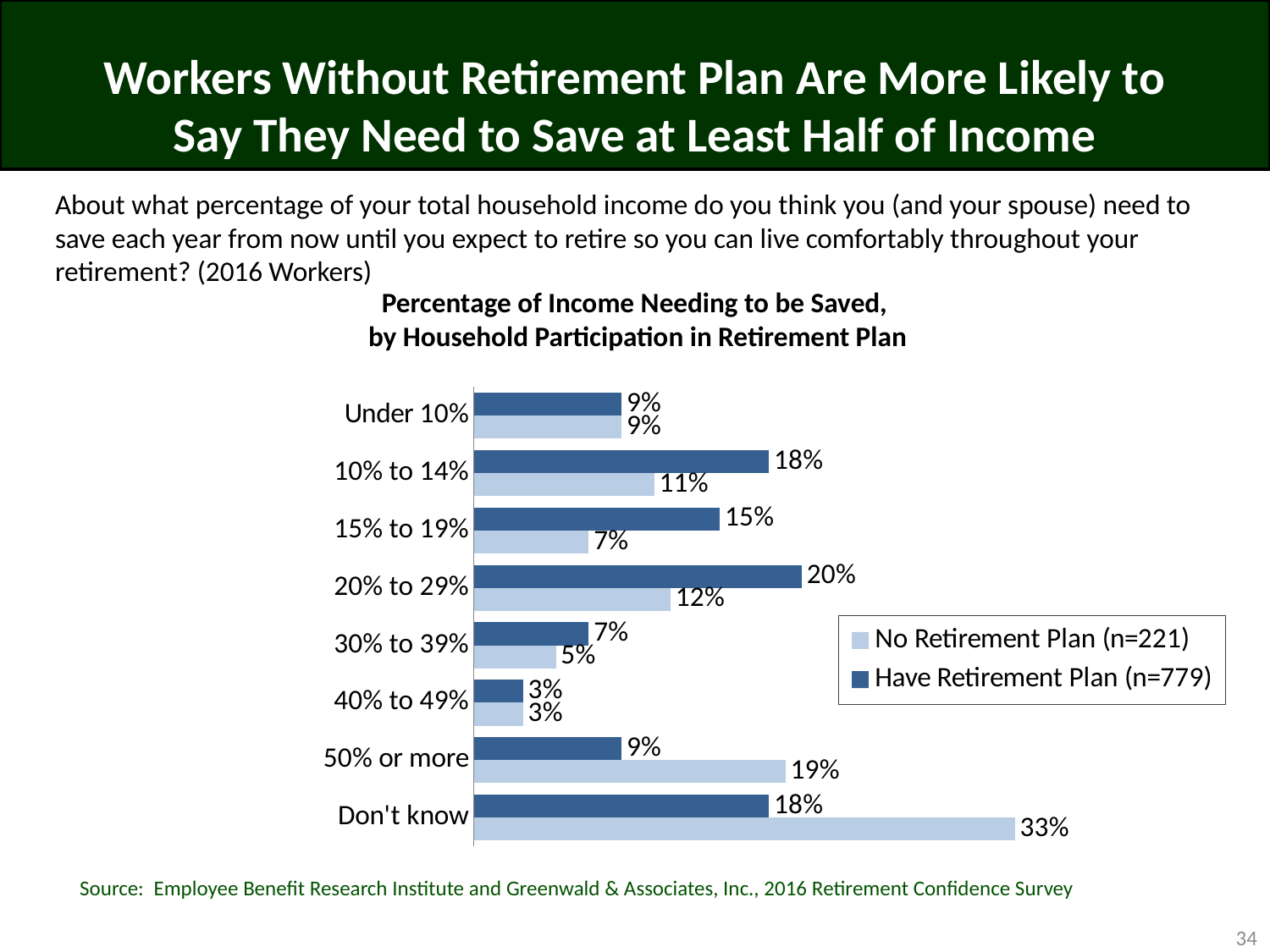
How many series does the legend list? 2 What is the difference between the No Retirement Plan and Have Retirement Plan values for "Don't know"? 15% Which category has the lowest value for the Have Retirement Plan series? 40% to 49% How many response categories are shown on the chart? 8 What percentage of workers without a retirement plan say they need to save 50% or more of income? 19% What percentage of workers with a retirement plan say they need to save 20% to 29% of income? 20% For the 50% or more category, which group has the larger value: No Retirement Plan or Have Retirement Plan? No Retirement Plan What percentage of workers without a retirement plan answered "Don't know"? 33% Which category has the highest value for the No Retirement Plan series? Don't know What percentage of workers with a retirement plan say they need to save 15% to 19% of income? 15% What type of chart is shown on the slide? Bar chart Which category has the highest value for the Have Retirement Plan series? 20% to 29%